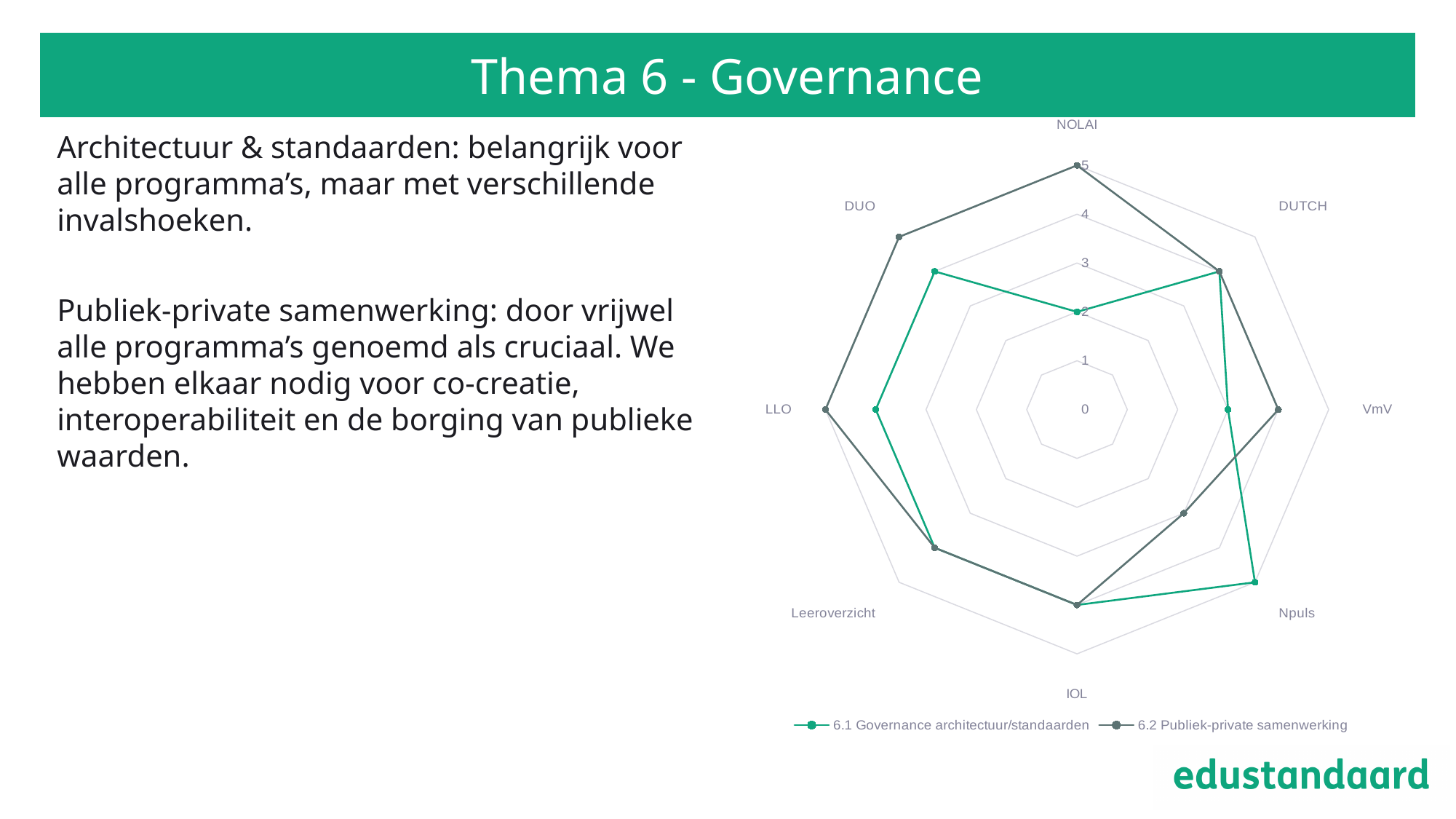
Which category has the lowest value in the series 6.1 Governance architectuur/standaarden? NOLAI Which category has the highest value in the series 6.1 Governance architectuur/standaarden? Npuls Which category has the lowest value in the series 6.2 Publiek-private samenwerking? Npuls How many categories (axes) does the radar chart have? 8 What is the value for Npuls in the series 6.1 Governance architectuur/standaarden? 5 What is the value for NOLAI in the series 6.2 Publiek-private samenwerking? 5 What is the difference between the two series' values for NOLAI? 3 How many series does the legend list? 2 What kind of chart is shown on the slide? Radar chart What is the value for Npuls in the series 6.2 Publiek-private samenwerking? 3 What is the value for NOLAI in the series 6.1 Governance architectuur/standaarden? 2 For VmV, which series has the larger value? 6.2 Publiek-private samenwerking